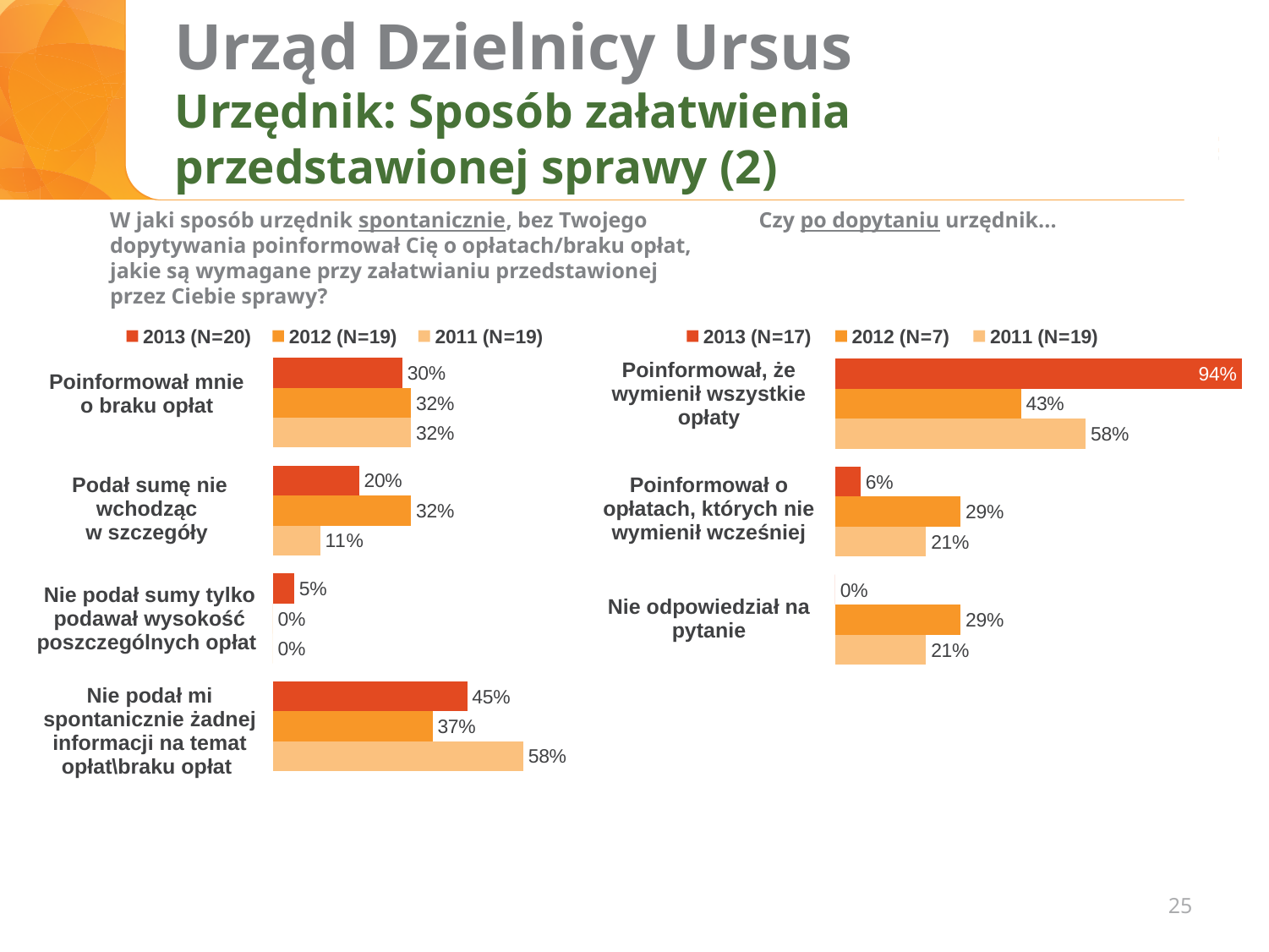
What type of chart is the left chart? Bar chart In the right chart, what is the 2012 value for 'Nie odpowiedział na pytanie'? 29% In the right chart, what sample size (N) is given for 2012 in the legend? N=7 How many categories does the left chart show? 4 In the left chart, what is the 2013 value for 'Nie podał mi spontanicznie żadnej informacji na temat opłat\braku opłat'? 45% In the right chart, which category has the lowest 2013 value? Nie odpowiedział na pytanie In the right chart, what is the 2013 value for 'Poinformował, że wymienił wszystkie opłaty'? 94% In the right chart, what is the difference between the 2013 and 2012 values for 'Poinformował, że wymienił wszystkie opłaty'? 51 percentage points In the left chart, what is the 2011 value for 'Podał sumę nie wchodząc w szczegóły'? 11% In the left chart, which category has the highest 2011 value? Nie podał mi spontanicznie żadnej informacji na temat opłat\braku opłat How many series does the legend of the right chart list? 3 In the left chart, which is larger for 'Podał sumę nie wchodząc w szczegóły': the 2013 value or the 2012 value? 2012